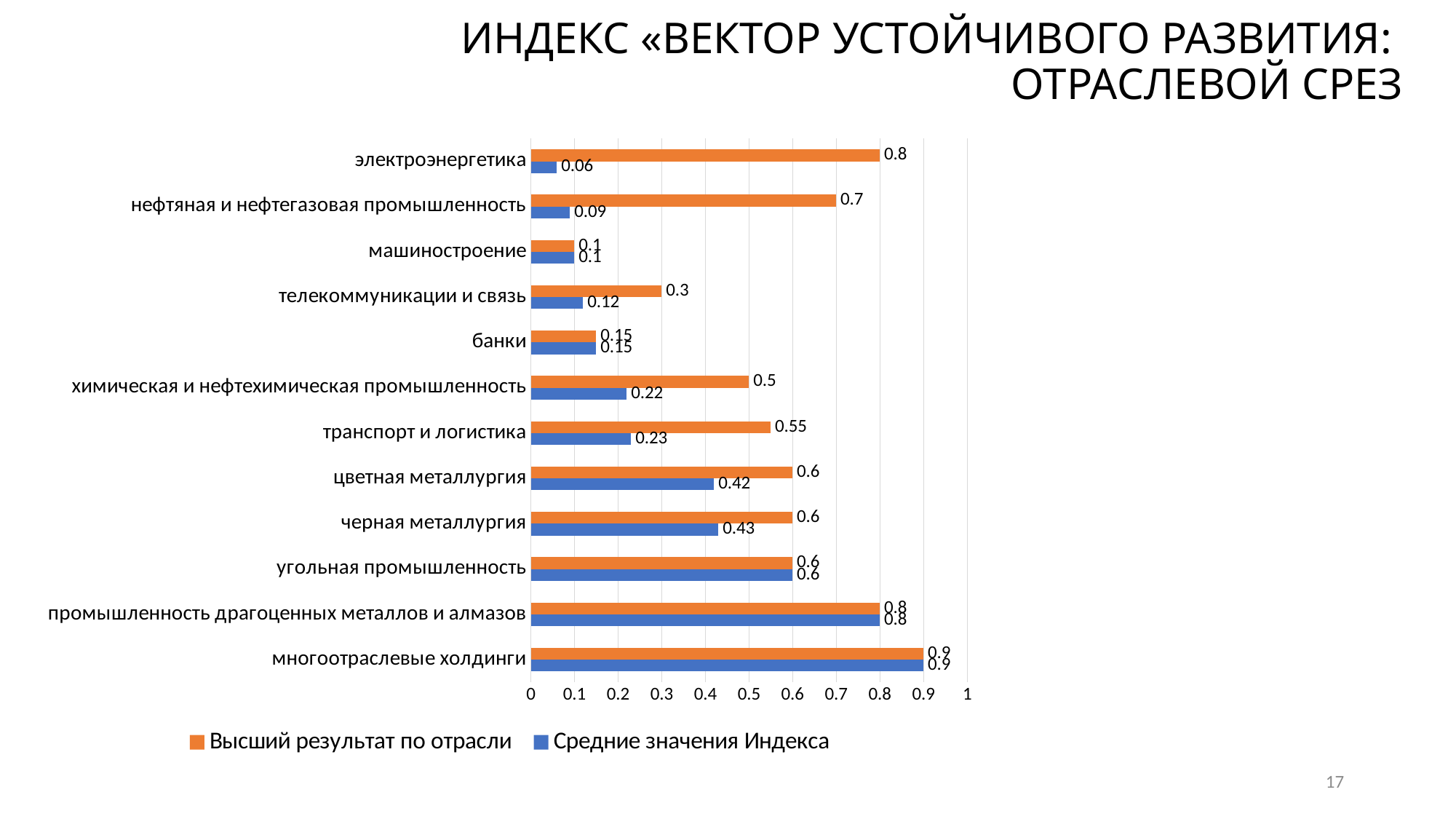
What is the difference between «Высший результат по отрасли» and «Средние значения Индекса» for нефтяная и нефтегазовая промышленность? 0.61 How many series does the legend list? 2 What is the difference between «Высший результат по отрасли» and «Средние значения Индекса» for электроэнергетика? 0.74 Which category has the lowest value of «Средние значения Индекса»? электроэнергетика What is the value of «Средние значения Индекса» for черная металлургия? 0.43 What is the value of «Высший результат по отрасли» for транспорт и логистика? 0.55 Which colour represents «Средние значения Индекса» in the chart? Blue Which category has the highest value of «Средние значения Индекса»? многоотраслевые холдинги What is the value of «Средние значения Индекса» for электроэнергетика? 0.06 Which is larger: «Средние значения Индекса» for цветная металлургия or for телекоммуникации и связь? цветная металлургия What kind of chart is shown on the slide? Bar chart How many categories (industries) are shown on the chart? 12